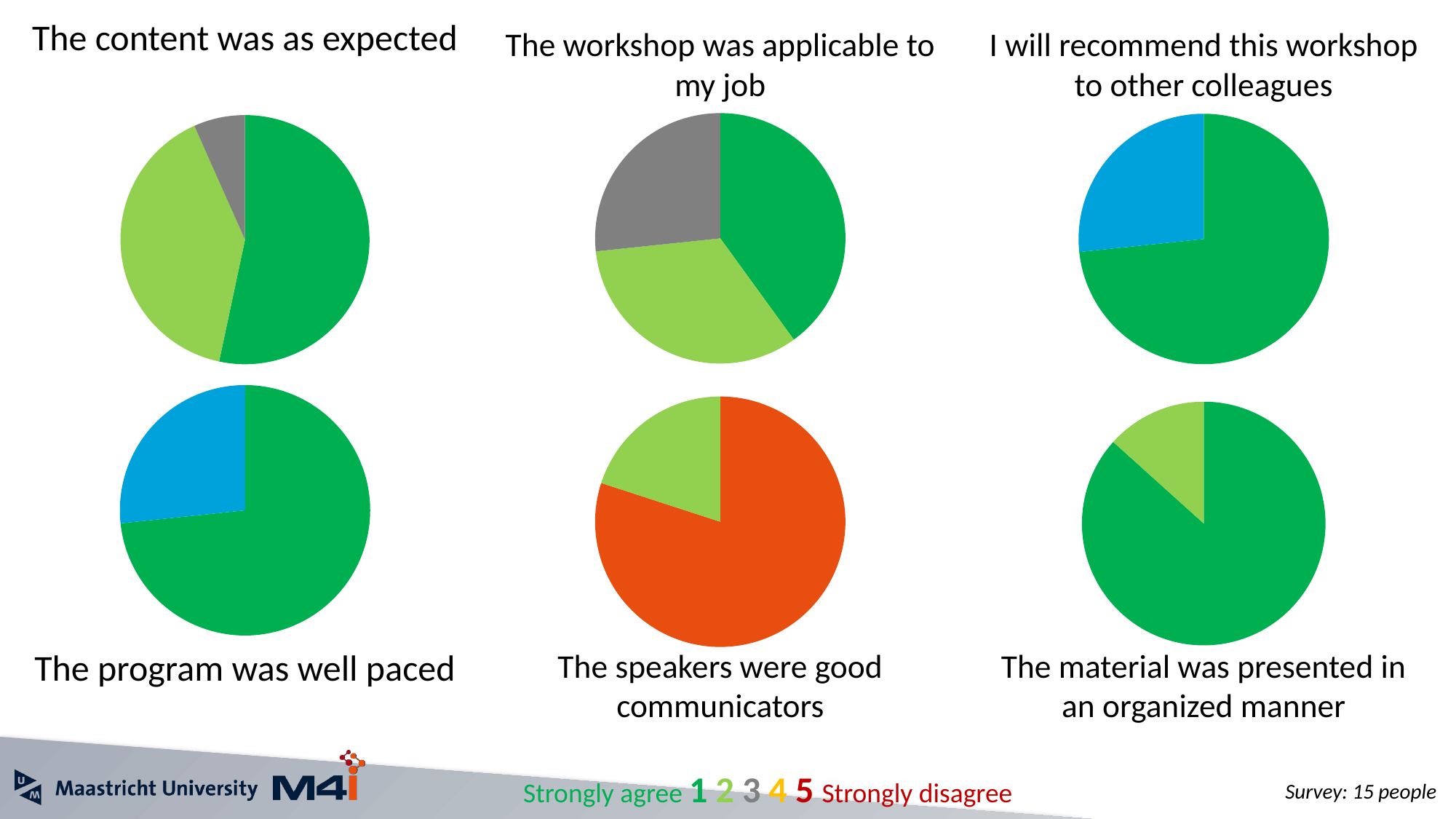
In the pie chart "The content was as expected", is the dark green slice larger or smaller than the grey slice? Larger How many slices does the pie chart "The content was as expected" have? 3 How many slices does the pie chart "I will recommend this workshop to other colleagues" have? 2 How many pie charts are shown on the slide? 6 In the pie chart "The workshop was applicable to my job", which colour slice is the smallest? Grey How many slices does the pie chart "The workshop was applicable to my job" have? 3 What kind of chart is used for "The content was as expected"? Pie chart In the pie chart "The speakers were good communicators", which colour slice is the largest? Red (orange-red) According to the legend at the bottom of the slide, which rating number corresponds to "Strongly disagree"? 5